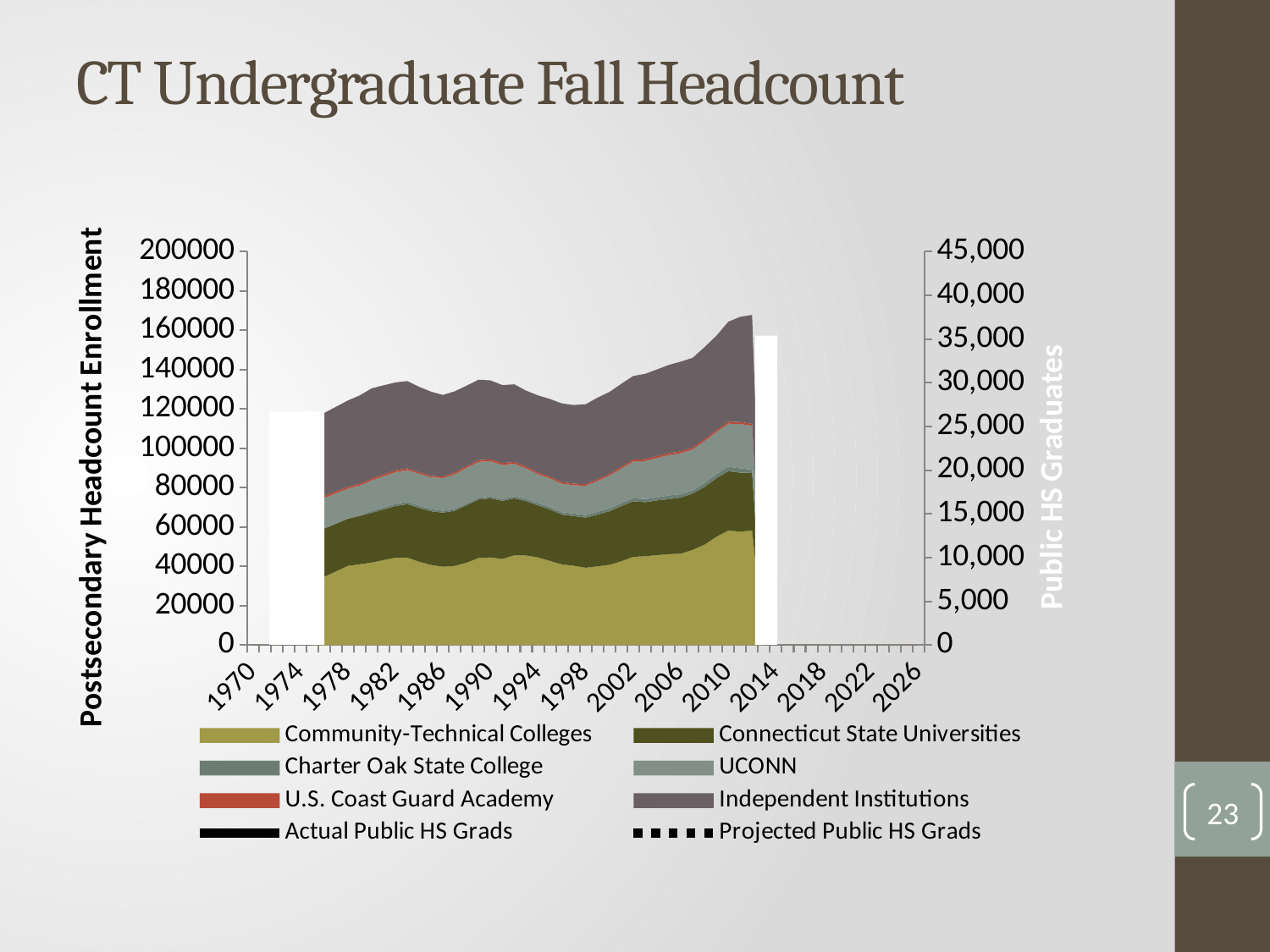
What is the highest tick value shown on the right vertical axis? 45,000 What kind of chart is shown on the slide? stacked area chart Is the total stacked enrollment around 2012 greater or less than 160000? greater Is the total stacked enrollment in 1978 greater or less than 140000? less Does the total stacked enrollment rise or fall between 2000 and 2012? rise What is the label of the left vertical axis? Postsecondary Headcount Enrollment Which is larger around 2010, Community-Technical Colleges or Charter Oak State College? Community-Technical Colleges Which series contributes the smallest band to the stack? U.S. Coast Guard Academy Is the Community-Technical Colleges value around 2012 greater or less than 40000? greater What is the title of the chart? CT Undergraduate Fall Headcount How many series does the legend list? 8 Which series forms the bottom layer of the stacked area? Community-Technical Colleges